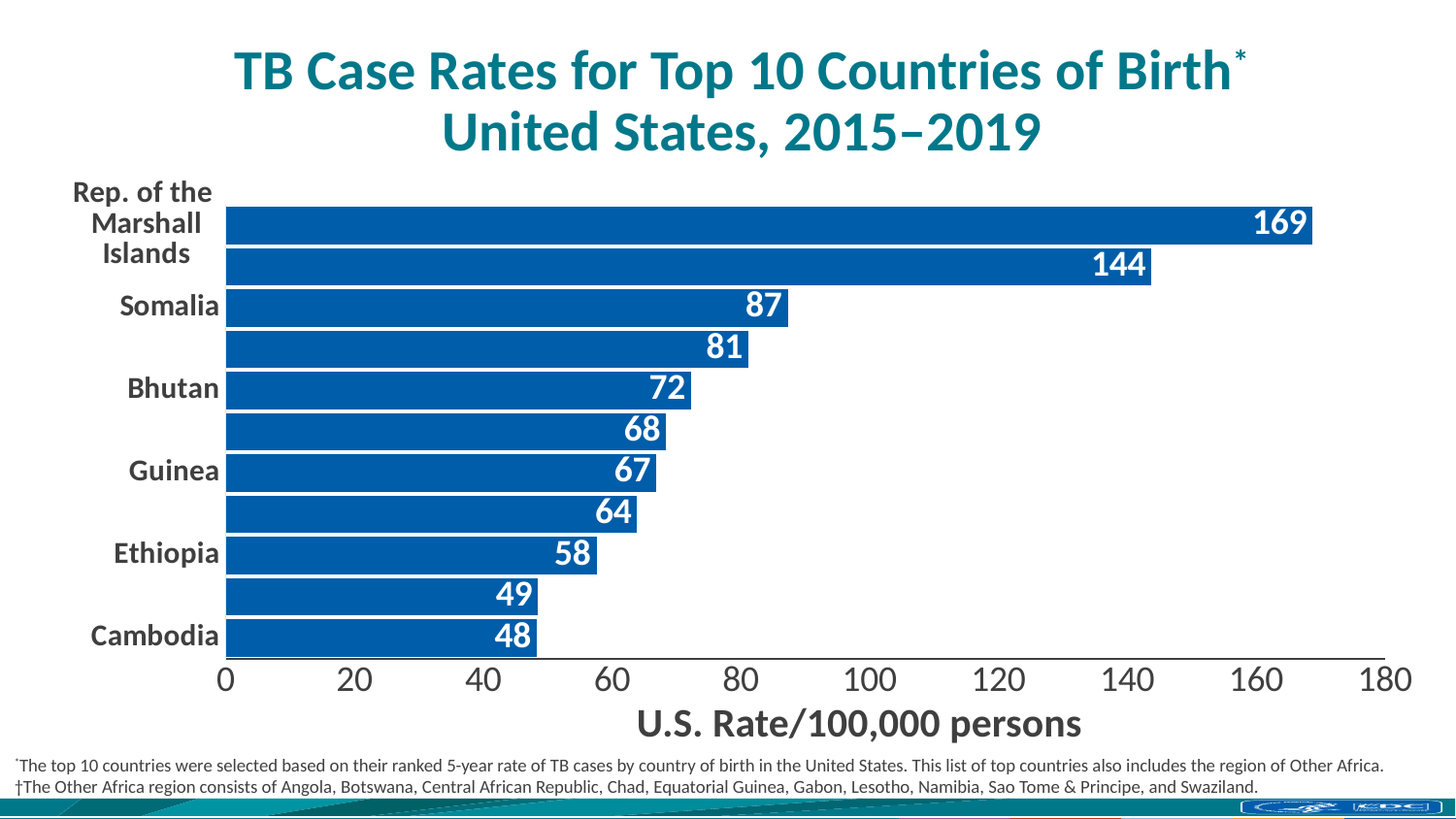
What is the TB case rate for Bhutan? 72 Which country of birth has the lowest TB case rate on the chart? Cambodia What kind of chart is shown on the slide? Bar chart What is the TB case rate for the Republic of the Marshall Islands? 169 What is the TB case rate for Ethiopia? 58 What is the difference between the TB case rates for Somalia and Bhutan? 15 What is the TB case rate for Guinea? 67 How many bars are plotted on the chart? 11 Which country of birth has the highest TB case rate on the chart? Rep. of the Marshall Islands What is the TB case rate for Cambodia? 48 Which has a higher TB case rate, Guinea or Ethiopia? Guinea What is the TB case rate for Somalia? 87